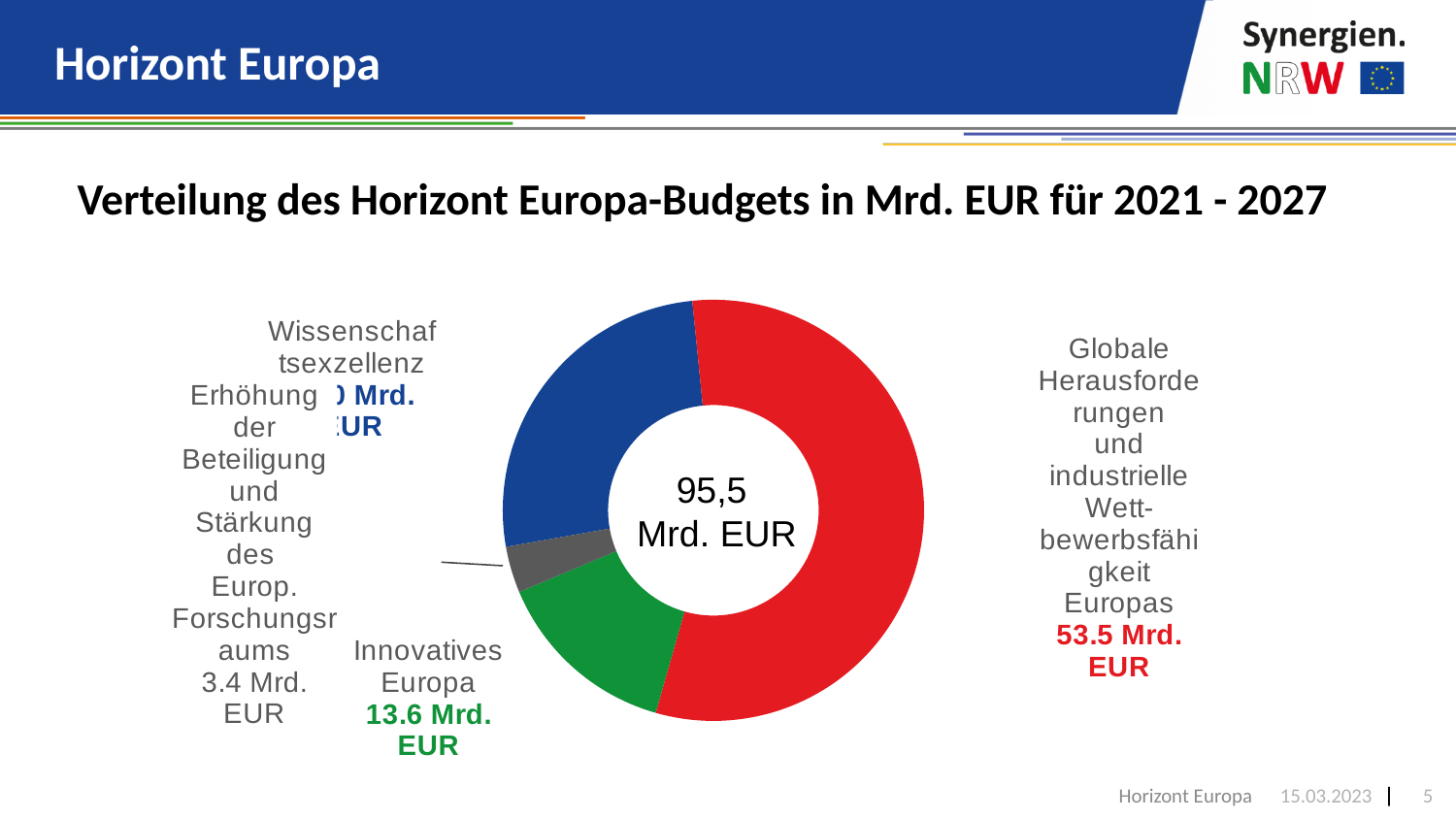
What is the title of the chart? Verteilung des Horizont Europa-Budgets in Mrd. EUR für 2021 - 2027 What is the difference between Globale Herausforderungen und industrielle Wettbewerbsfähigkeit Europas and Innovatives Europa? 39.9 Mrd. EUR What colour is the slice for Innovatives Europa? green How many slices does the chart have? 4 What kind of chart is shown on the slide? doughnut chart What is the total budget shown in the centre of the chart? 95,5 Mrd. EUR Which is larger, Innovatives Europa or Erhöhung der Beteiligung und Stärkung des Europ. Forschungsraums? Innovatives Europa What is the value for Globale Herausforderungen und industrielle Wettbewerbsfähigkeit Europas? 53.5 Mrd. EUR Which category has the largest slice of the chart? Globale Herausforderungen und industrielle Wettbewerbsfähigkeit Europas What is the value for Innovatives Europa? 13.6 Mrd. EUR What is the value for Erhöhung der Beteiligung und Stärkung des Europ. Forschungsraums? 3.4 Mrd. EUR Which category has the smallest slice of the chart? Erhöhung der Beteiligung und Stärkung des Europ. Forschungsraums